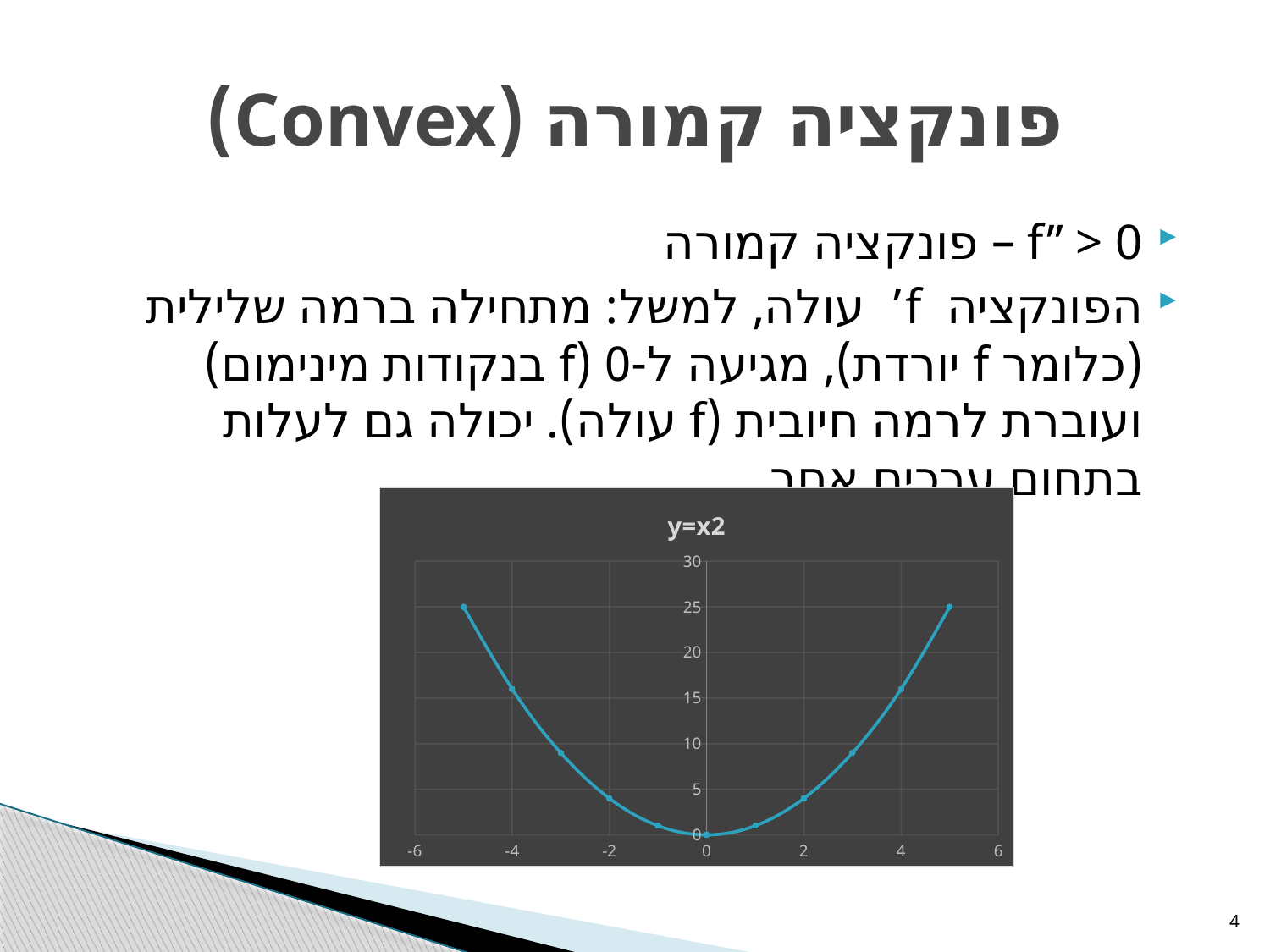
Which has the larger y value, x = -4 or x = -2? x = -4 What is the y value at x = -5? 25 How many data points are plotted on the chart? 11 Do the y values rise or fall as x increases from 0 to 5? rise Is the y value at x = 1 greater or less than 5? less At which x value does the curve reach its lowest y value? 0 What kind of chart is shown on the slide? line chart What is the y value at x = 0? 0 What is the title of the chart? y=x2 What is the y value at x = 5? 25 Is the y value at x = 3 greater or less than 5? greater Is the y value at x = -4 greater or less than 10? greater